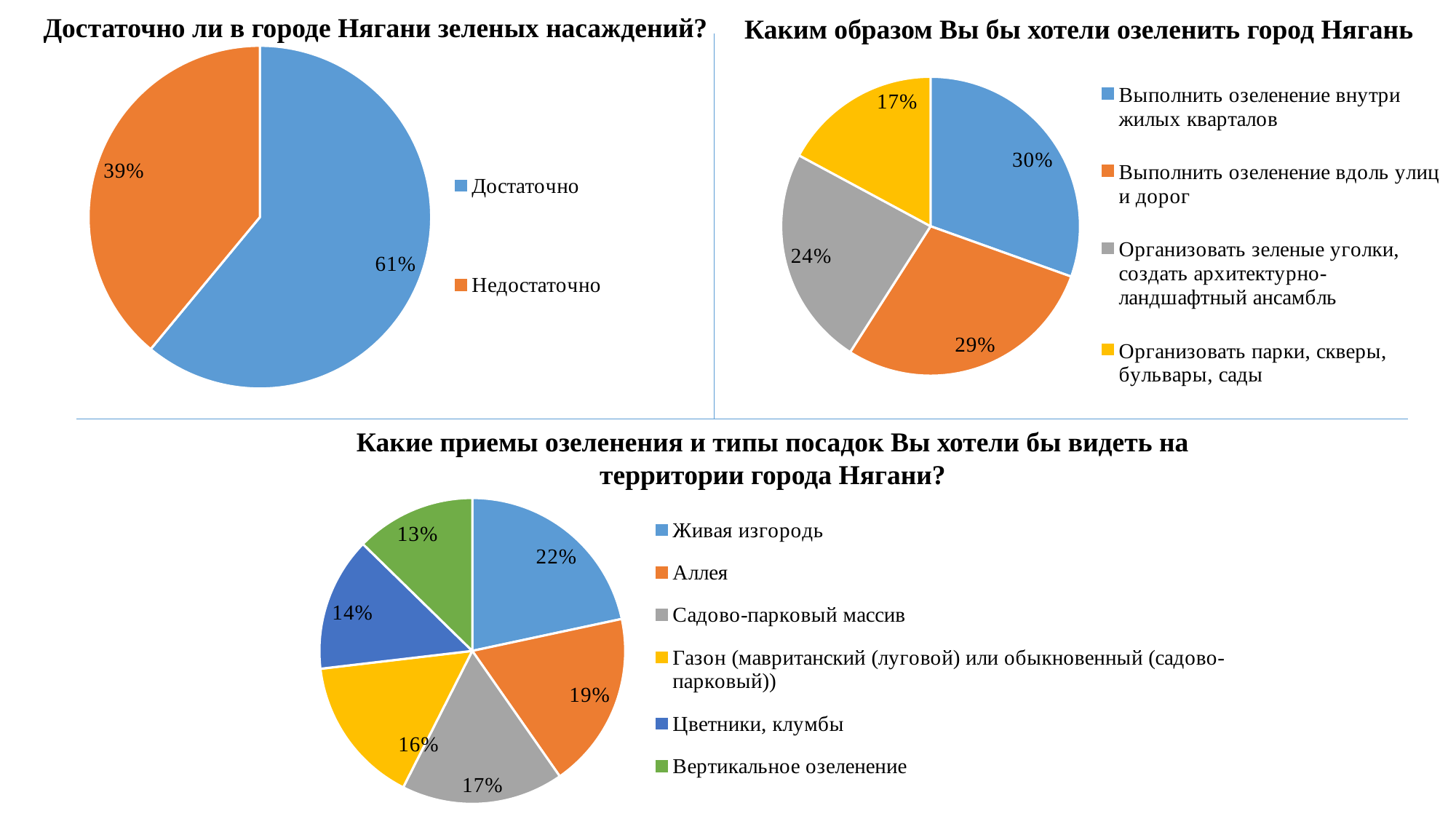
In the top-right chart 'Каким образом Вы бы хотели озеленить город Нягань', what share is for 'Организовать зеленые уголки, создать архитектурно-ландшафтный ансамбль'? 24% In the bottom chart 'Какие приемы озеленения и типы посадок Вы хотели бы видеть на территории города Нягани?', which option has the largest share? Живая изгородь In the top-right chart 'Каким образом Вы бы хотели озеленить город Нягань', how many options does the legend list? 4 In the bottom chart 'Какие приемы озеленения и типы посадок Вы хотели бы видеть на территории города Нягани?', which is larger: 'Цветники, клумбы' or 'Вертикальное озеленение'? Цветники, клумбы In the top-left chart 'Достаточно ли в городе Нягани зеленых насаждений?', what is the difference between the 'Достаточно' and 'Недостаточно' shares? 22% In the top-right chart 'Каким образом Вы бы хотели озеленить город Нягань', what is the difference between 'Выполнить озеленение внутри жилых кварталов' and 'Организовать парки, скверы, бульвары, сады'? 13% In the top-right chart 'Каким образом Вы бы хотели озеленить город Нягань', which option has the smallest share? Организовать парки, скверы, бульвары, сады In the bottom chart 'Какие приемы озеленения и типы посадок Вы хотели бы видеть на территории города Нягани?', what share is for 'Аллея'? 19% What kind of chart is the top-left chart 'Достаточно ли в городе Нягани зеленых насаждений?'? Pie chart In the bottom chart 'Какие приемы озеленения и типы посадок Вы хотели бы видеть на территории города Нягани?', what colour is the 'Газон' slice? Yellow In the bottom chart 'Какие приемы озеленения и типы посадок Вы хотели бы видеть на территории города Нягани?', how many slices does the pie have? 6 In the top-left chart 'Достаточно ли в городе Нягани зеленых насаждений?', what share of respondents answered 'Достаточно'? 61%